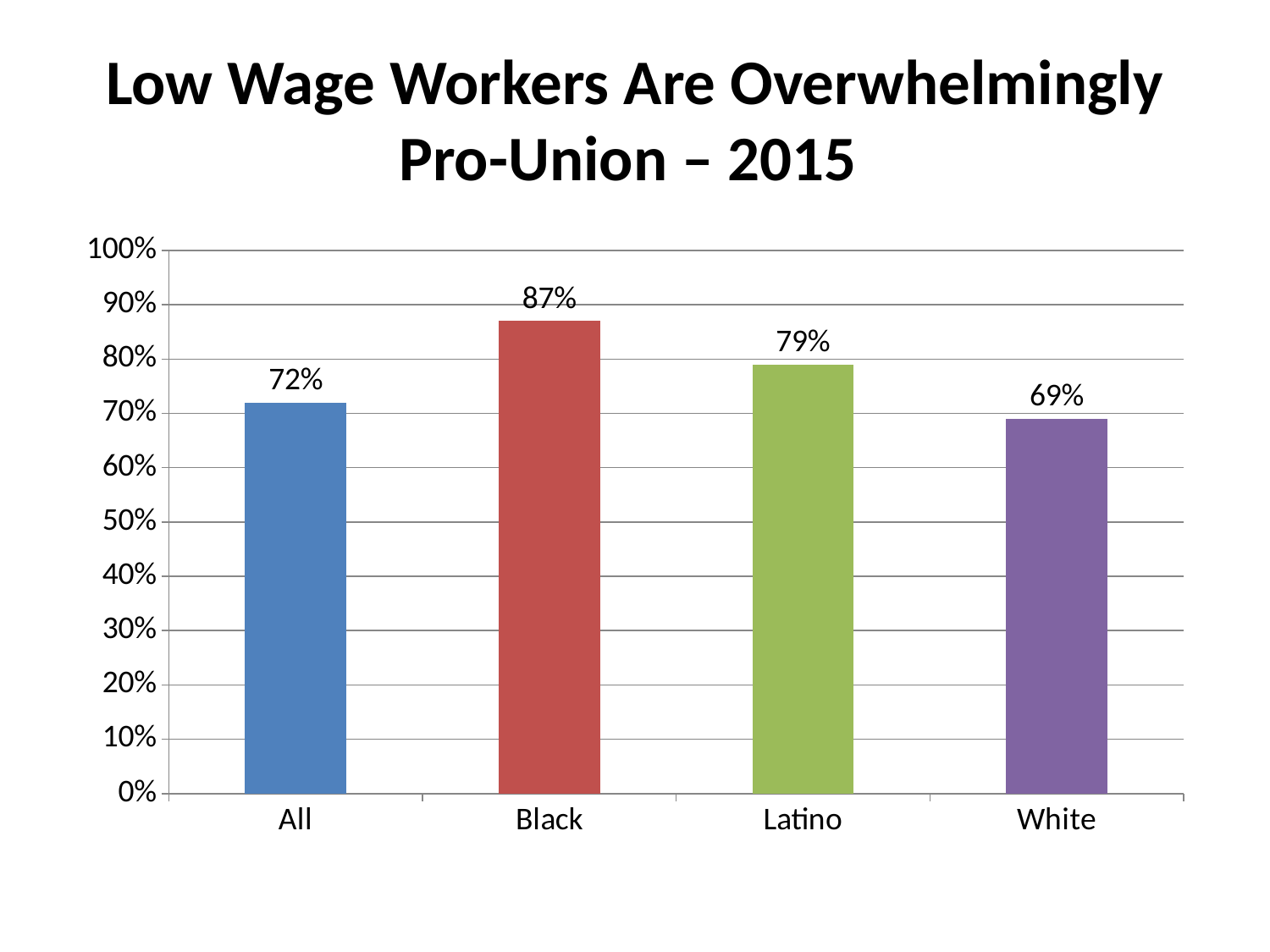
Which is larger, the value for Latino or the value for All? Latino Which category has the lowest value? White Which category has the highest value? Black What is the value for Latino? 79% Is the value for White greater or less than 60%? greater What is the value for White? 69% What is the value for All? 72% What is the difference between the values for Black and White? 18% How many categories are shown on the x axis? 4 What kind of chart is shown on the slide? bar chart What is the value for Black? 87% What is the difference between the values for Latino and All? 7%